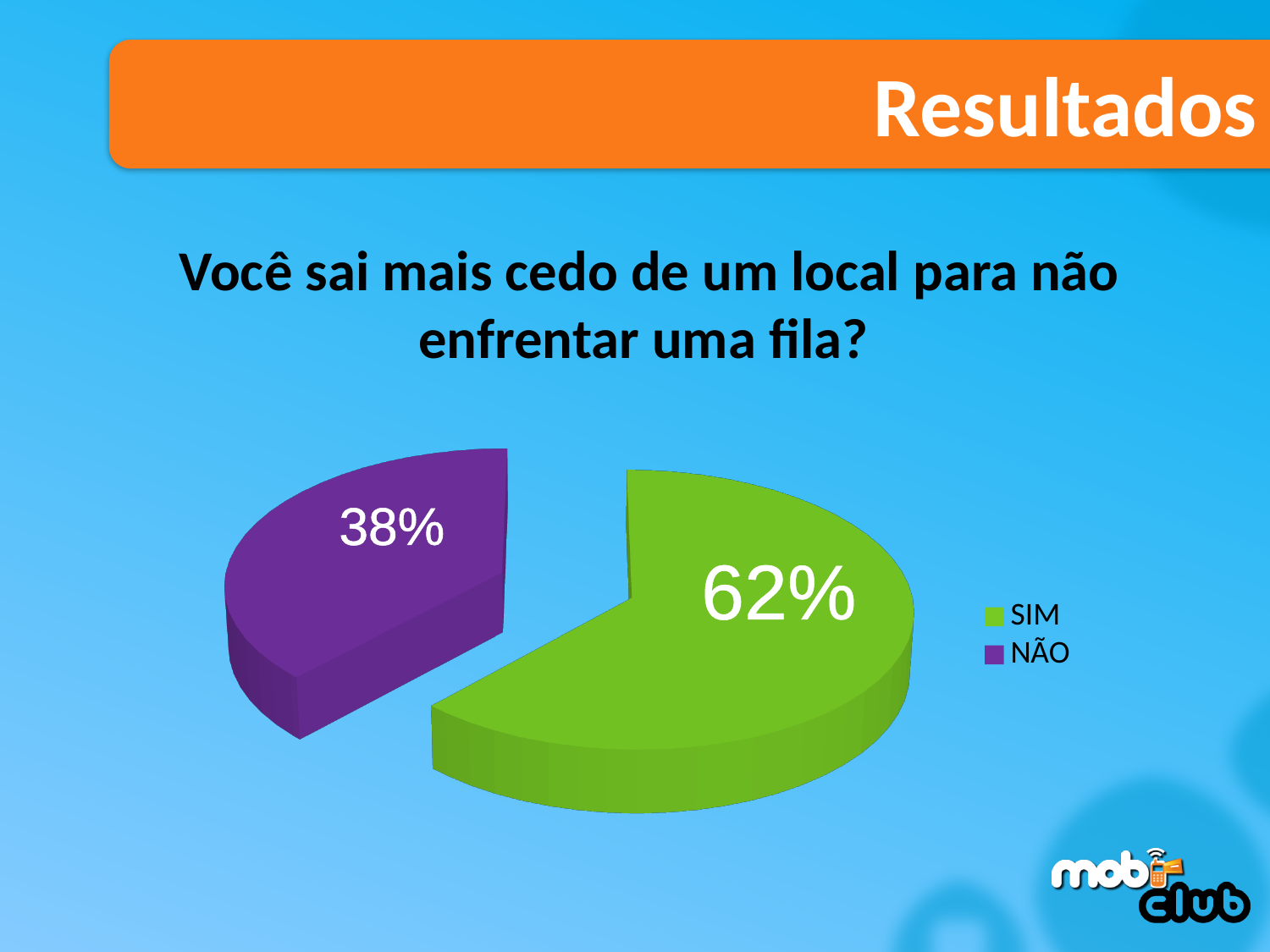
What is the difference in percentage points between the SIM and NÃO slices? 24 How many slices does the pie chart have? 2 How many entries does the legend list? 2 What colour is the NÃO slice? purple What share of the pie does the SIM slice represent? 62% What question is the pie chart answering, according to the text above it? Você sai mais cedo de um local para não enfrentar uma fila? What percentage of respondents answered NÃO? 38% Which response has the smallest share of the pie? NÃO Which response has the largest share of the pie? SIM What kind of chart is shown on the slide? pie chart Which slice is larger, SIM or NÃO? SIM What percentage of respondents answered SIM? 62%